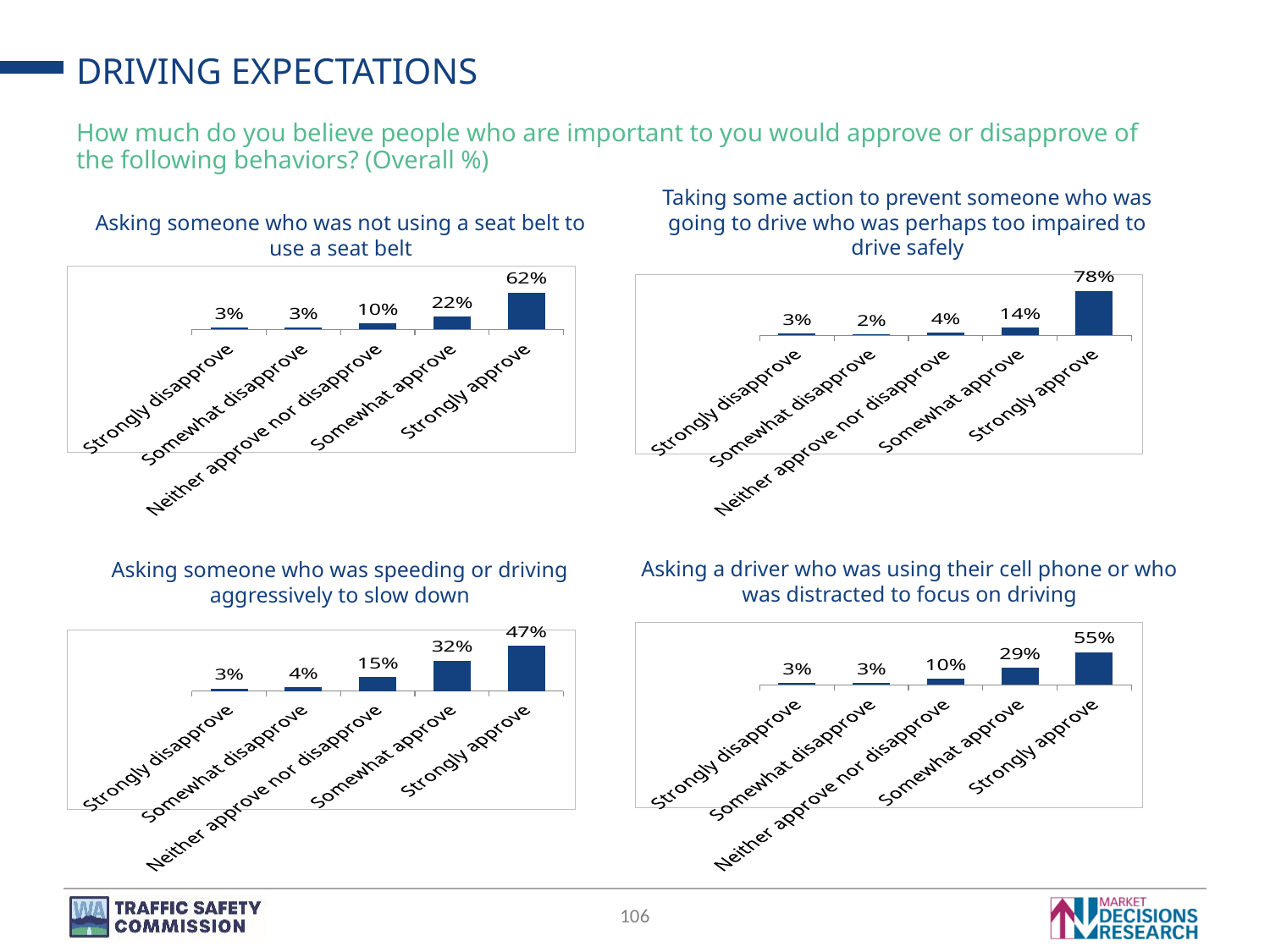
In the 'Asking a driver who was using their cell phone or who was distracted to focus on driving' chart, what is the value for Somewhat approve? 29% What kind of chart is the 'Asking a driver who was using their cell phone or who was distracted to focus on driving' chart? Bar chart In the 'Asking a driver who was using their cell phone or who was distracted to focus on driving' chart, what is the difference between Strongly approve and Somewhat approve? 26% In the 'Taking some action to prevent someone who was going to drive who was perhaps too impaired to drive safely' chart, what is the value for Somewhat approve? 14% In the 'Asking someone who was not using a seat belt to use a seat belt' chart, what is the value for Strongly approve? 62% How many categories are shown in the 'Asking someone who was speeding or driving aggressively to slow down' chart? 5 In the 'Asking someone who was speeding or driving aggressively to slow down' chart, which category has the highest value? Strongly approve In the 'Asking someone who was not using a seat belt to use a seat belt' chart, do the values rise or fall from Strongly disapprove to Strongly approve? Rise In the 'Taking some action to prevent someone who was going to drive who was perhaps too impaired to drive safely' chart, which category has the lowest value? Somewhat disapprove In the 'Asking someone who was speeding or driving aggressively to slow down' chart, what is the value for Neither approve nor disapprove? 15% In the 'Asking someone who was not using a seat belt to use a seat belt' chart, what is the difference between Strongly approve and Somewhat approve? 40% Which is larger: Strongly approve in the 'Taking some action to prevent someone who was going to drive who was perhaps too impaired to drive safely' chart or Strongly approve in the 'Asking someone who was speeding or driving aggressively to slow down' chart? Taking some action to prevent someone who was going to drive who was perhaps too impaired to drive safely